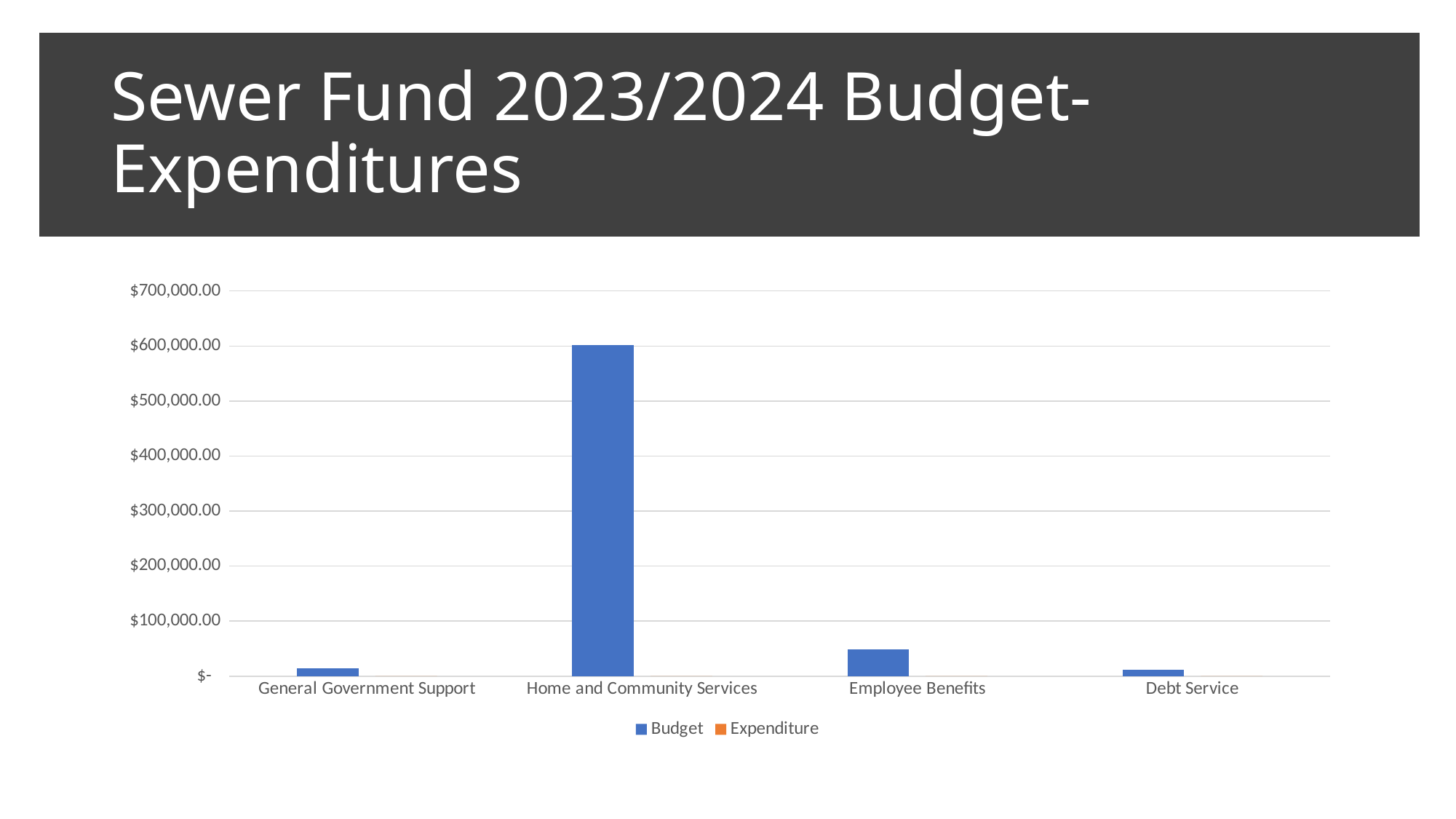
How many series does the chart's legend list? 2 How many categories are shown on the x axis of the chart? 4 Is the Budget value for Debt Service greater or less than $100,000.00? less Is the Budget value for Home and Community Services greater or less than $500,000.00? greater Which category has the highest Budget value? Home and Community Services Is the Budget value for General Government Support greater or less than $100,000.00? less What kind of chart is shown on the slide? Bar chart What is the title of the slide containing the chart? Sewer Fund 2023/2024 Budget-Expenditures Which has the larger Budget value, Employee Benefits or General Government Support? Employee Benefits Which has the larger Budget value, Home and Community Services or Employee Benefits? Home and Community Services What are the two series named in the chart's legend? Budget and Expenditure